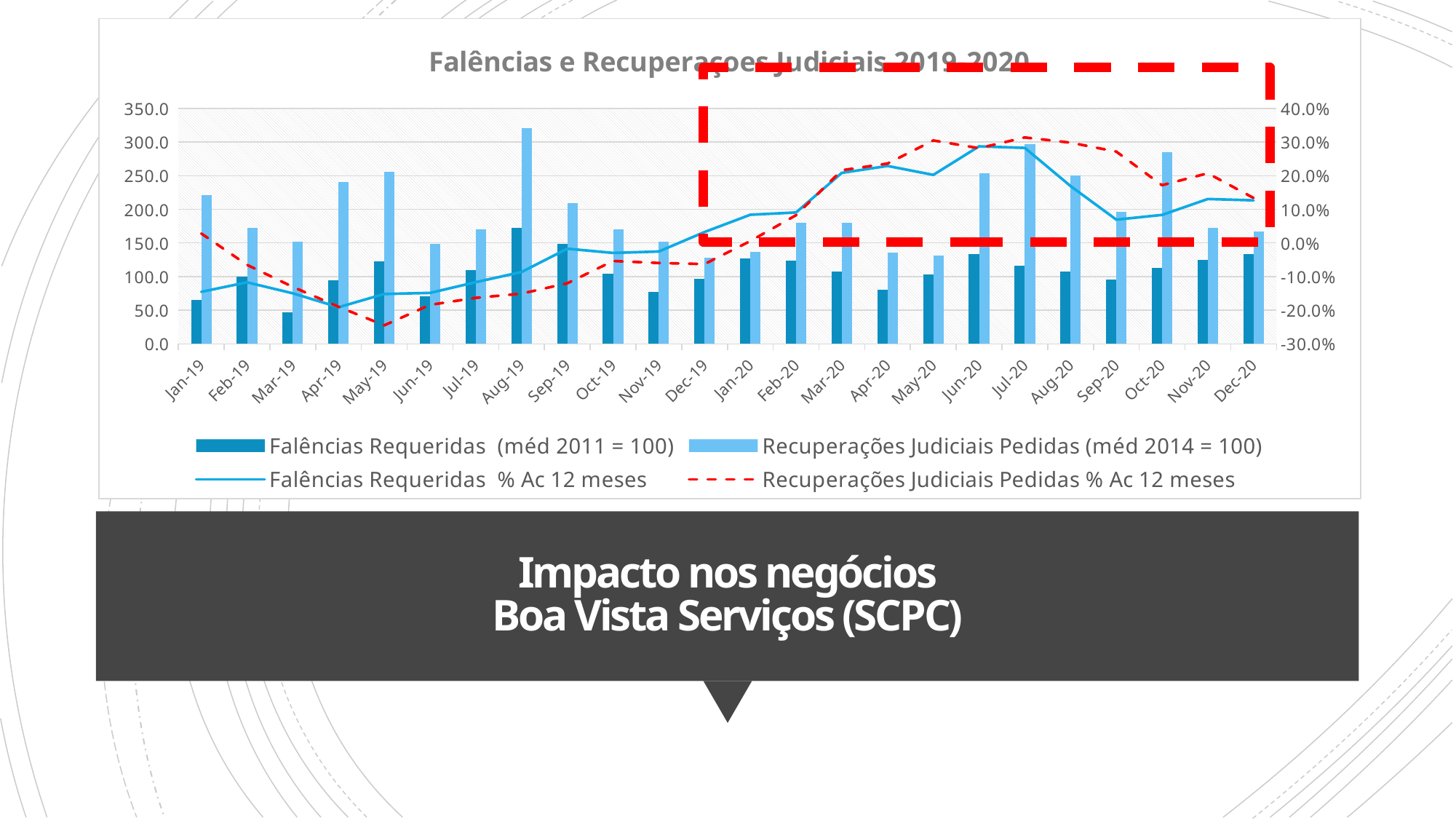
In which month is the bar for Recuperações Judiciais Pedidas (méd 2014 = 100) the highest? Aug-19 Which series is drawn as a red dashed line in the chart? Recuperações Judiciais Pedidas % Ac 12 meses Is the Recuperações Judiciais Pedidas (méd 2014 = 100) bar for Aug-19 greater or less than 300? greater How many series does the chart's legend list? 4 Which month has the larger Recuperações Judiciais Pedidas (méd 2014 = 100) bar, Apr-19 or Jan-20? Apr-19 In which month is the bar for Falências Requeridas (méd 2011 = 100) the lowest? Mar-19 Is the Recuperações Judiciais Pedidas (méd 2014 = 100) bar for Jul-20 greater or less than 250? greater What kind of chart is shown on the slide? A combined bar and line chart Does the Falências Requeridas % Ac 12 meses line rise or fall between Jan-19 and Jun-20? rise How many months are shown along the x axis of the chart? 24 In which month is the bar for Falências Requeridas (méd 2011 = 100) the highest? Aug-19